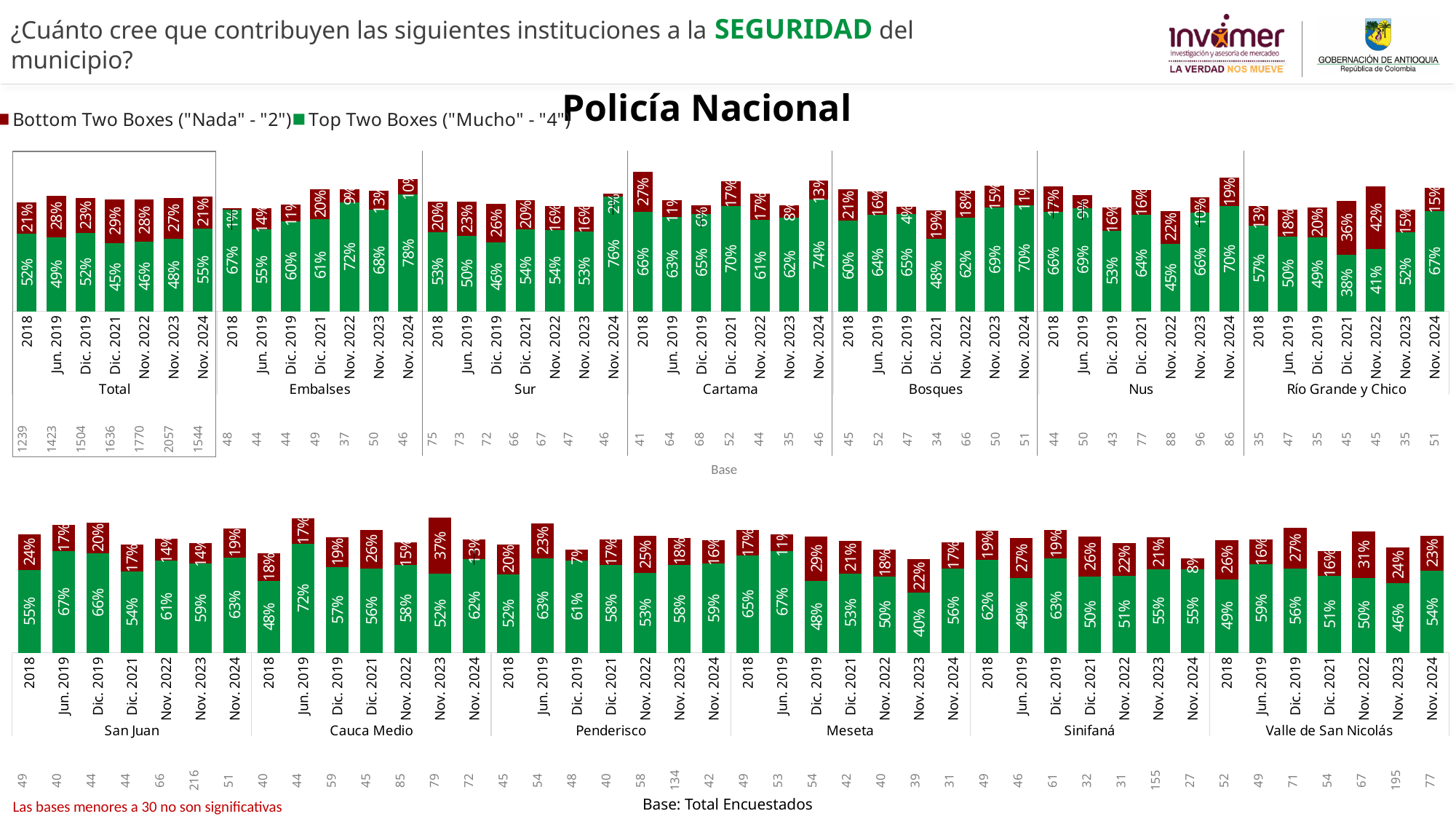
What kind of chart is shown on the slide? Stacked bar chart What is the Top Two Boxes value for Embalses in Nov. 2024? 78% Which is larger: the Top Two Boxes value for Cartama in 2018 or for Bosques in 2018? Cartama in 2018 What is the difference between the Top Two Boxes values for Sur in Nov. 2024 and Nov. 2023? 23% Within the Total group, which year has the highest Top Two Boxes value? Nov. 2024 How many series does the legend list? 2 What is the Bottom Two Boxes value for Río Grande y Chico in Nov. 2022? 42% How many time periods are shown for each region group? 7 What is the Bottom Two Boxes value for Cauca Medio in Nov. 2023? 37% What is the Top Two Boxes value for Total in Nov. 2024? 55% What is the combined total of Top Two Boxes and Bottom Two Boxes for Río Grande y Chico in Nov. 2022? 83% Within the Meseta group, which year has the lowest Top Two Boxes value? Nov. 2023